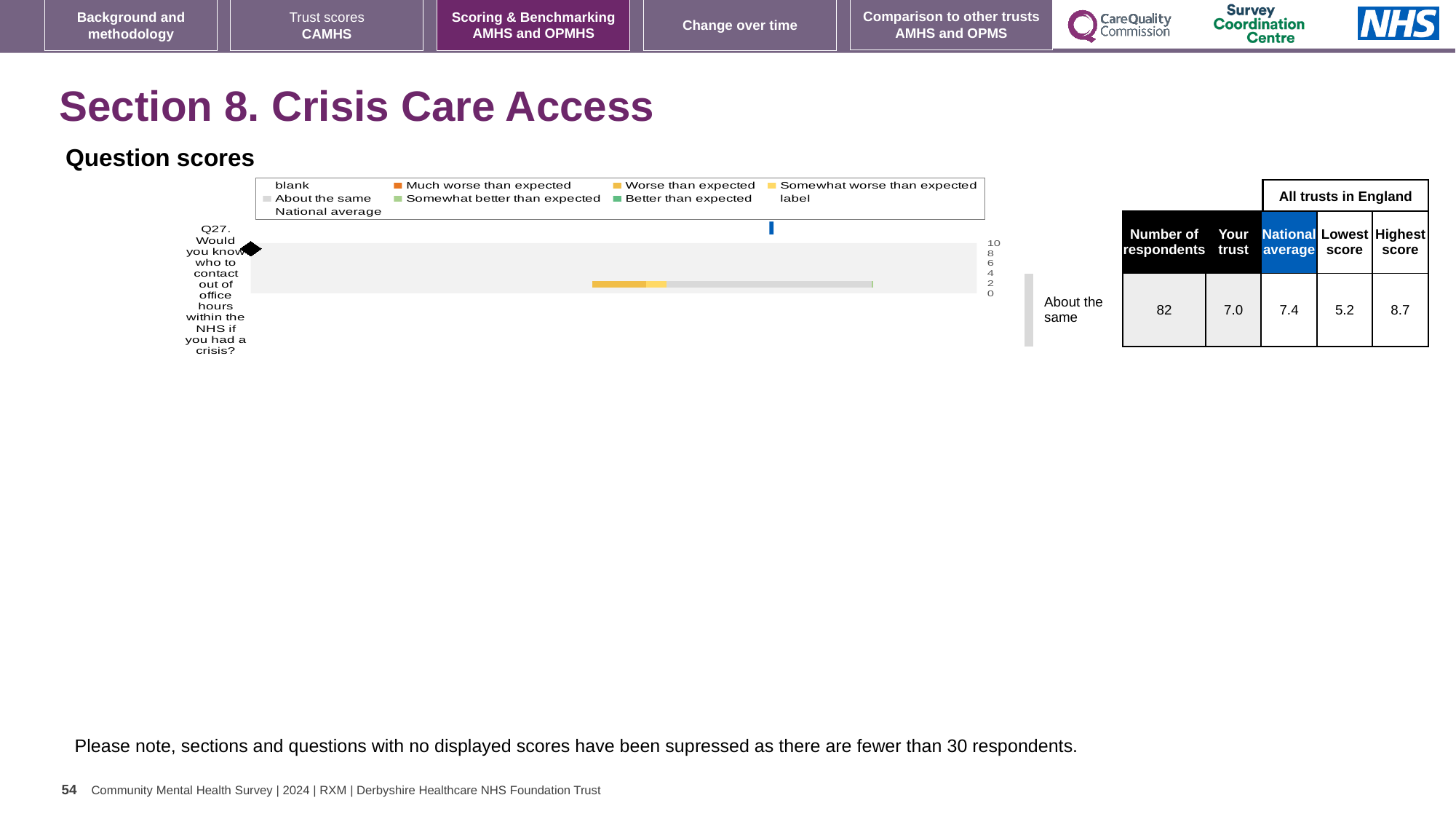
How many questions (categories) are plotted in the Question scores chart? 1 Which question number is plotted in the Question scores chart? Q27 In the table beside the chart, what is the number of respondents for Q27? 82 Which is larger for Q27: the trust's score or the national average? National average What is the difference between the highest score (8.7) and the lowest score (5.2) for Q27? 3.5 What benchmark rating is shown beside the chart for Q27? About the same In the table beside the chart, what is the highest score among all trusts in England for Q27? 8.7 What is the maximum value shown on the score axis of the Question scores chart? 10 In the table beside the chart, what is the national average score for Q27? 7.4 What kind of chart is used to show the Q27 question score? Bar chart How many entries does the legend of the Question scores chart list? 9 In the table beside the chart, what is the 'Your trust' score for Q27? 7.0